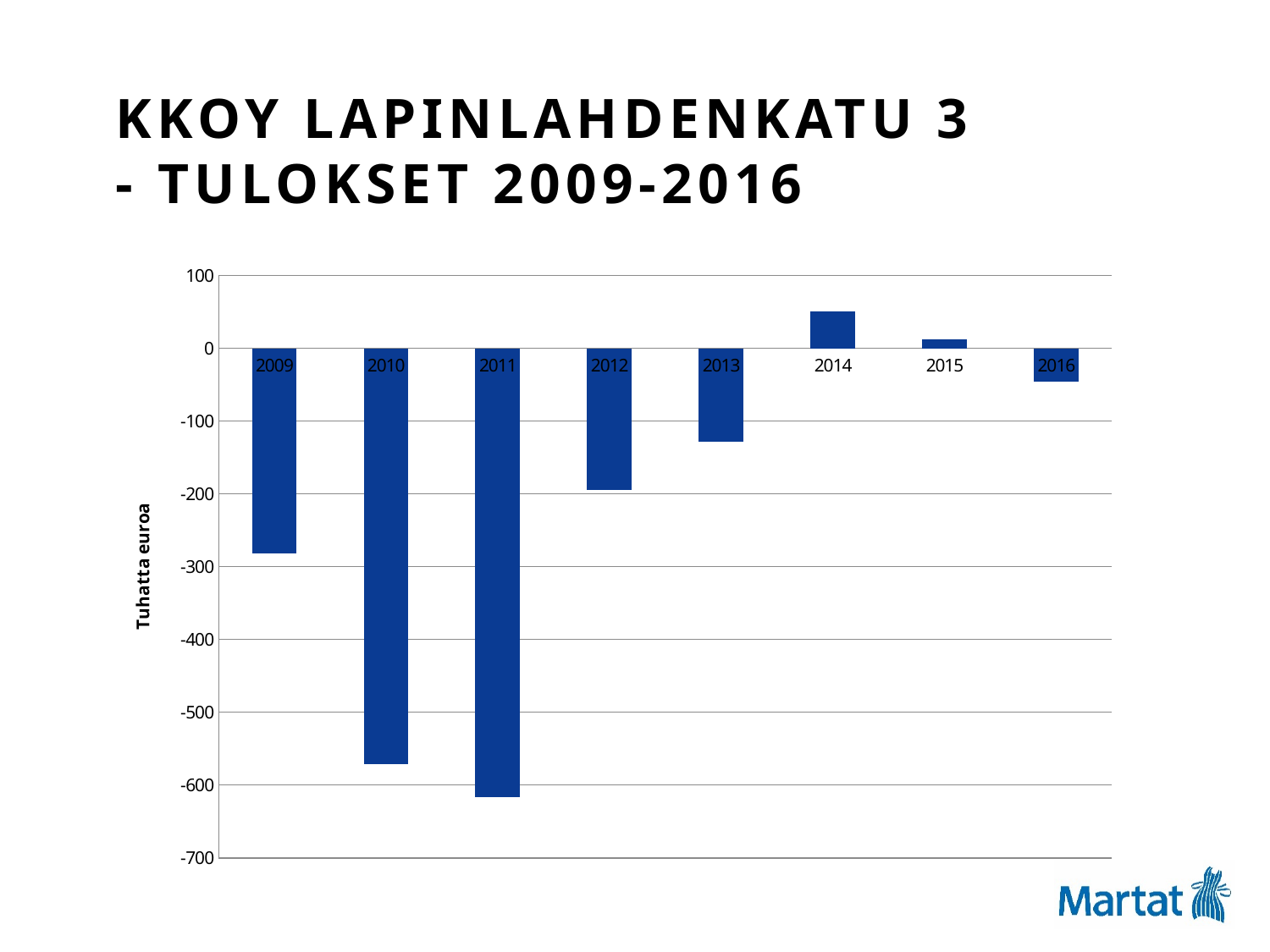
Which year has the highest value in the chart? 2014 Which year has the larger value, 2009 or 2012? 2012 What is the label on the vertical axis of the chart? Tuhatta euroa How many years (bars) are plotted in the chart? 8 Which year has the lowest value in the chart? 2011 Do the values rise or fall from 2011 to 2014? rise Is the value for 2009 greater or less than -200? less Is the value for 2013 greater or less than -100? less Is the value for 2014 greater or less than 0? greater What kind of chart is shown on the slide? bar chart